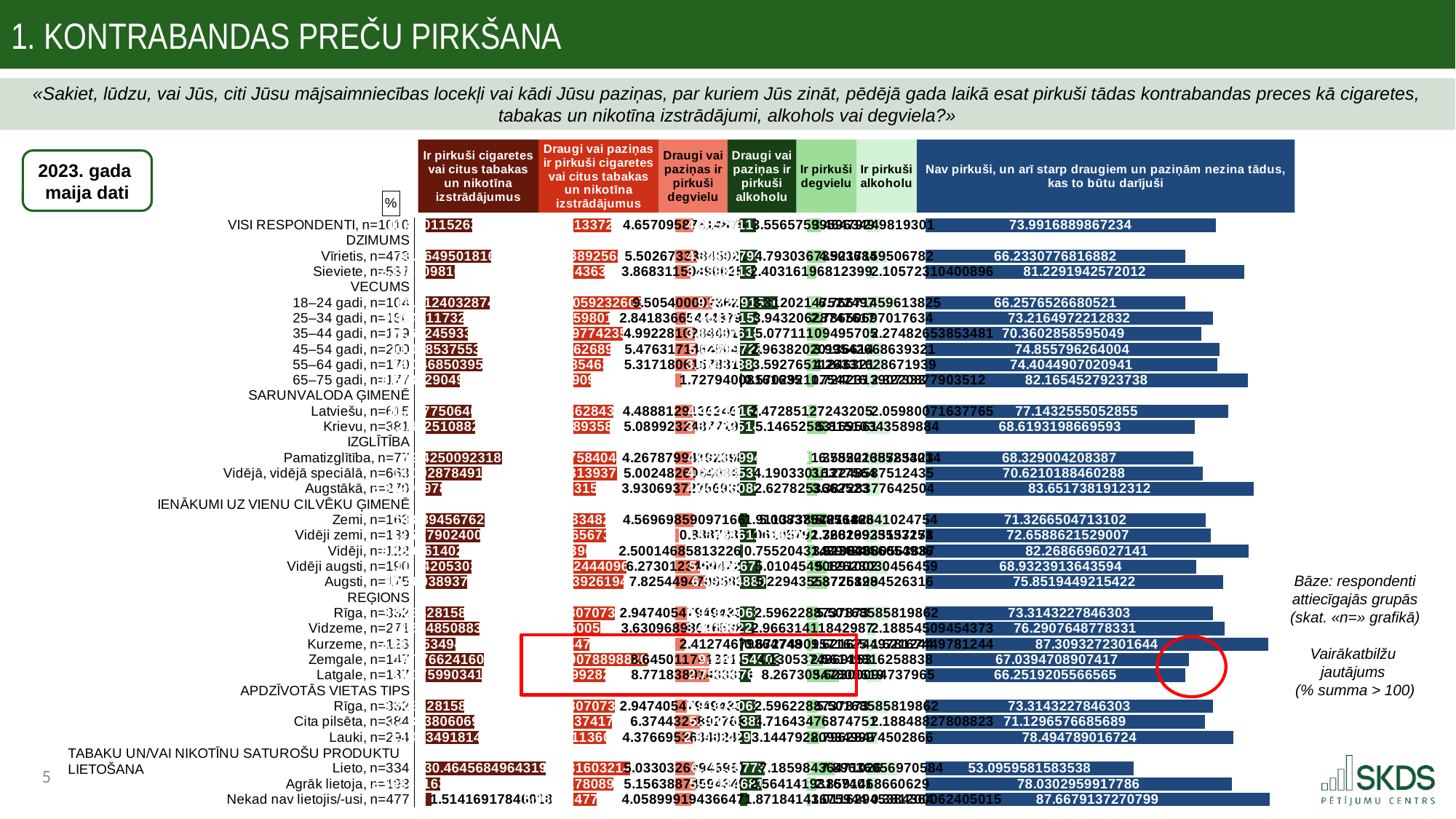
For "Nav pirkuši, un arī starp draugiem un paziņām nezina tādus, kas to būtu darījuši", which is larger: Vīrietis or Sieviete? Sieviete What is the value of "Nav pirkuši, un arī starp draugiem un paziņām nezina tādus, kas to būtu darījuši" for Nekad nav lietojis/-usi, n=477? 87.6679137270799 What is the value of "Nav pirkuši, un arī starp draugiem un paziņām nezina tādus, kas to būtu darījuši" for Sieviete? 81.2291942572012 Among the REĢIONS categories, which has the highest value for "Nav pirkuši, un arī starp draugiem un paziņām nezina tādus, kas to būtu darījuši"? Kurzeme What is the value of "Nav pirkuši, un arī starp draugiem un paziņām nezina tādus, kas to būtu darījuši" for VISI RESPONDENTI, n=1010? 73.9916889867234 Among the TABAKU UN/VAI NIKOTĪNU SATUROŠU PRODUKTU LIETOŠANA categories, which has the lowest value for "Nav pirkuši, un arī starp draugiem un paziņām nezina tādus, kas to būtu darījuši"? Lieto How many series does the legend list? 7 What is the difference between Sieviete and Vīrietis for "Nav pirkuši, un arī starp draugiem un paziņām nezina tādus, kas to būtu darījuši"? 14.996116575513 Among the REĢIONS categories, which has the lowest value for "Nav pirkuši, un arī starp draugiem un paziņām nezina tādus, kas to būtu darījuši"? Latgale What colour are the bars for the series "Nav pirkuši, un arī starp draugiem un paziņām nezina tādus, kas to būtu darījuši"? blue What kind of chart is shown on the slide? bar chart What is the value of "Ir pirkuši cigaretes vai citus tabakas un nikotīna izstrādājumus" for Lieto, n=334? 30.4645684964319